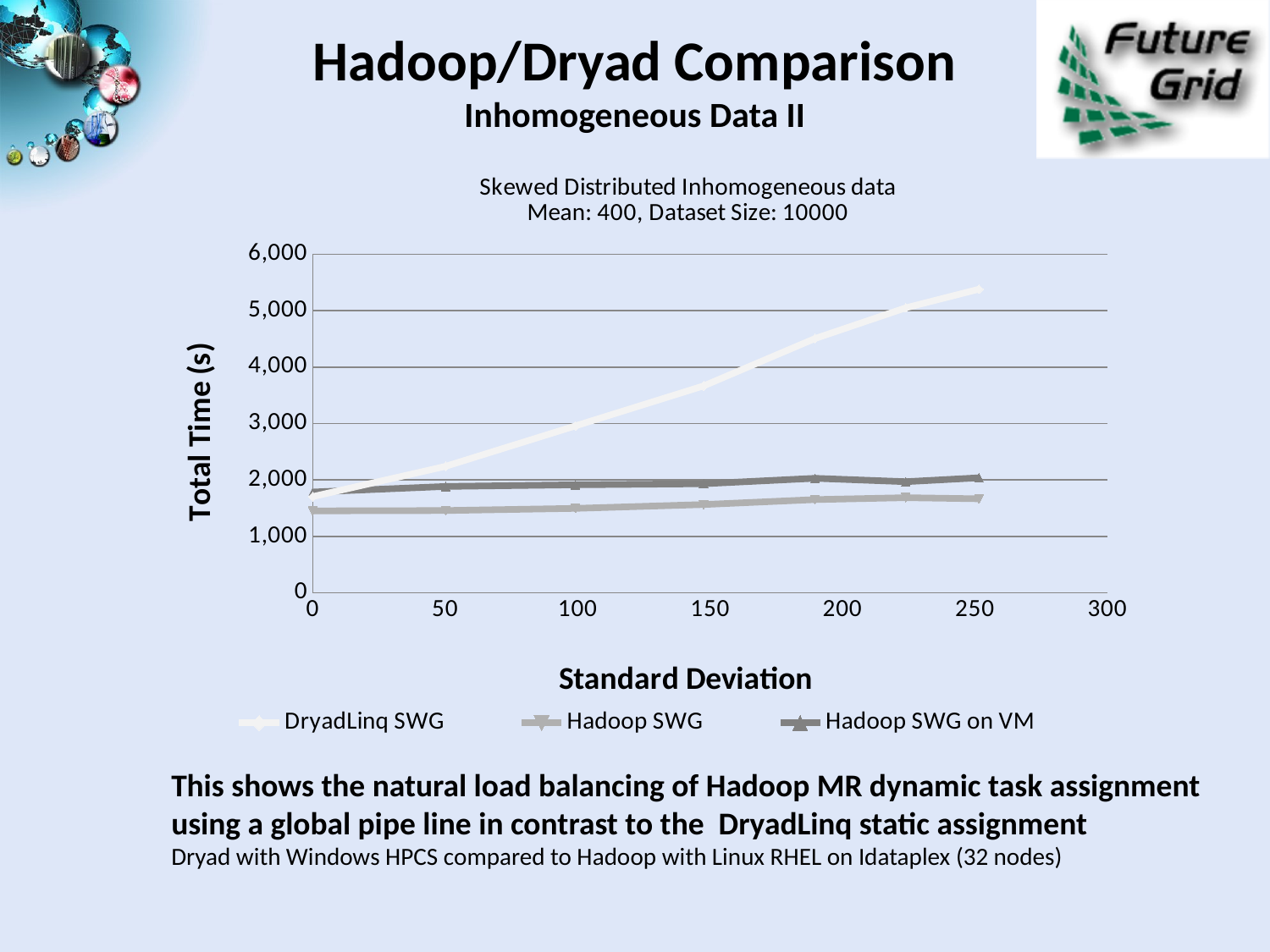
What kind of chart is shown on the slide? line chart What is the label of the y axis? Total Time (s) Is the value for Hadoop SWG at Standard Deviation 0 greater or less than 2,000? less What is the title of the chart? Skewed Distributed Inhomogeneous data Mean: 400, Dataset Size: 10000 Is the value for DryadLinq SWG at Standard Deviation 150 greater or less than 3,000? greater At Standard Deviation 250, which is larger: DryadLinq SWG or Hadoop SWG? DryadLinq SWG Which series has the lowest Total Time at Standard Deviation 250? Hadoop SWG Is the value for Hadoop SWG at Standard Deviation 250 greater or less than 2,000? less How many series does the legend list? 3 Does the DryadLinq SWG line rise or fall as Standard Deviation increases? rise Which series has the highest Total Time at Standard Deviation 250? DryadLinq SWG